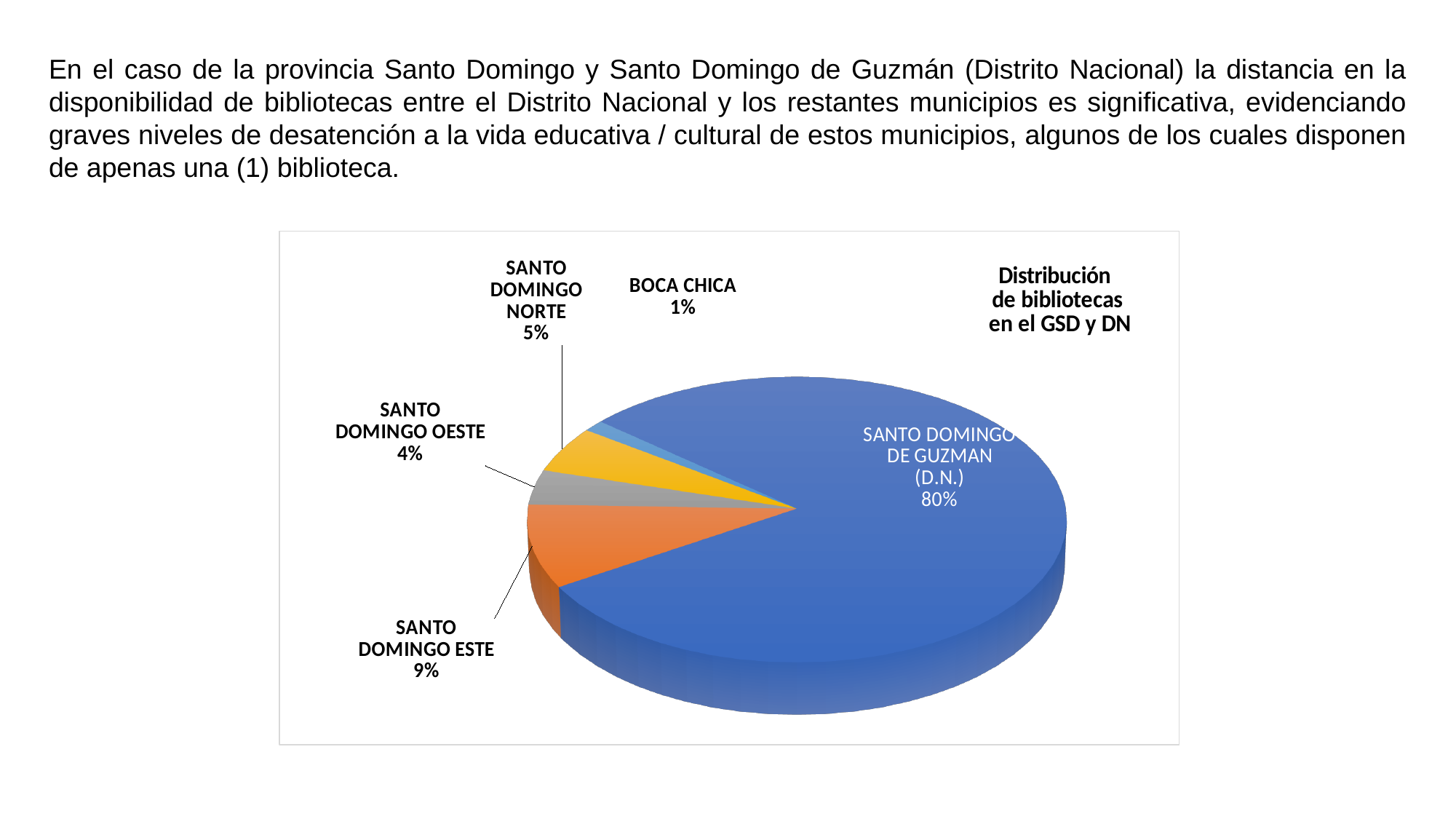
What share of the pie does Boca Chica hold? 1% How many slices does the pie chart have? 5 Which municipality has the largest slice of the pie? Santo Domingo de Guzman (D.N.) What is the difference in percentage points between Santo Domingo Este and Santo Domingo Norte? 4 What share of the pie does Santo Domingo Norte hold? 5% What share of the pie does Santo Domingo Oeste hold? 4% Which municipality has the smallest slice of the pie? Boca Chica Which has a larger share, Santo Domingo Norte or Santo Domingo Oeste? Santo Domingo Norte What is the title of the chart? Distribución de bibliotecas en el GSD y DN What kind of chart is shown on the slide? Pie chart